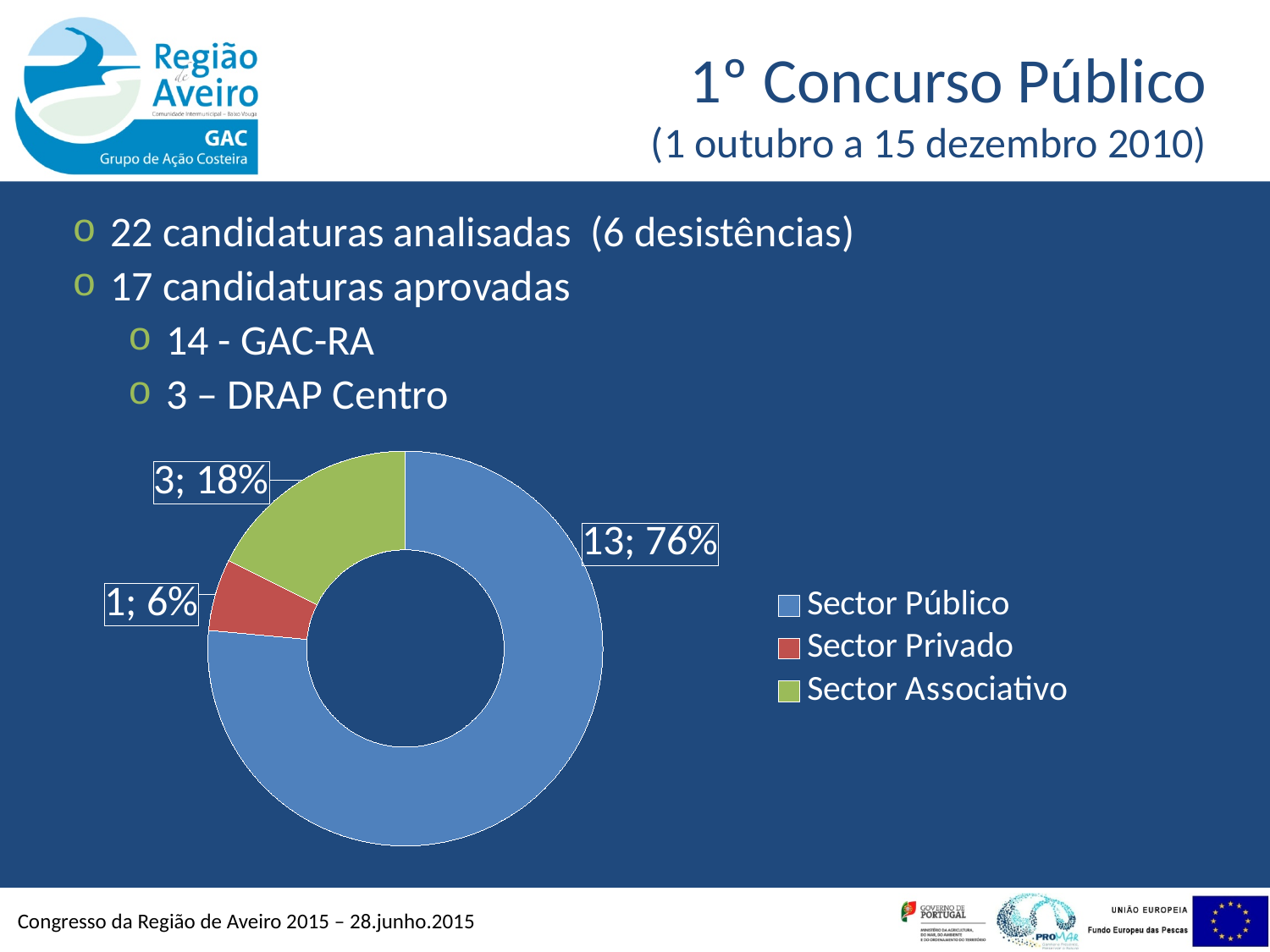
Which colour represents Sector Associativo in the doughnut chart? Green What is the count shown for Sector Público in the doughnut chart? 13 Which sector has the largest slice in the doughnut chart? Sector Público What percentage share does Sector Associativo have in the doughnut chart? 18% What is the count shown for Sector Privado in the doughnut chart? 1 Which sector has the smallest slice in the doughnut chart? Sector Privado How many sectors does the legend of the doughnut chart list? 3 What percentage share does Sector Público have in the doughnut chart? 76% Which is larger in the doughnut chart, Sector Associativo or Sector Privado? Sector Associativo What kind of chart is shown on the slide? Doughnut chart What is the difference between the counts for Sector Público and Sector Associativo in the doughnut chart? 10 What is the total of the counts shown across all slices of the doughnut chart? 17